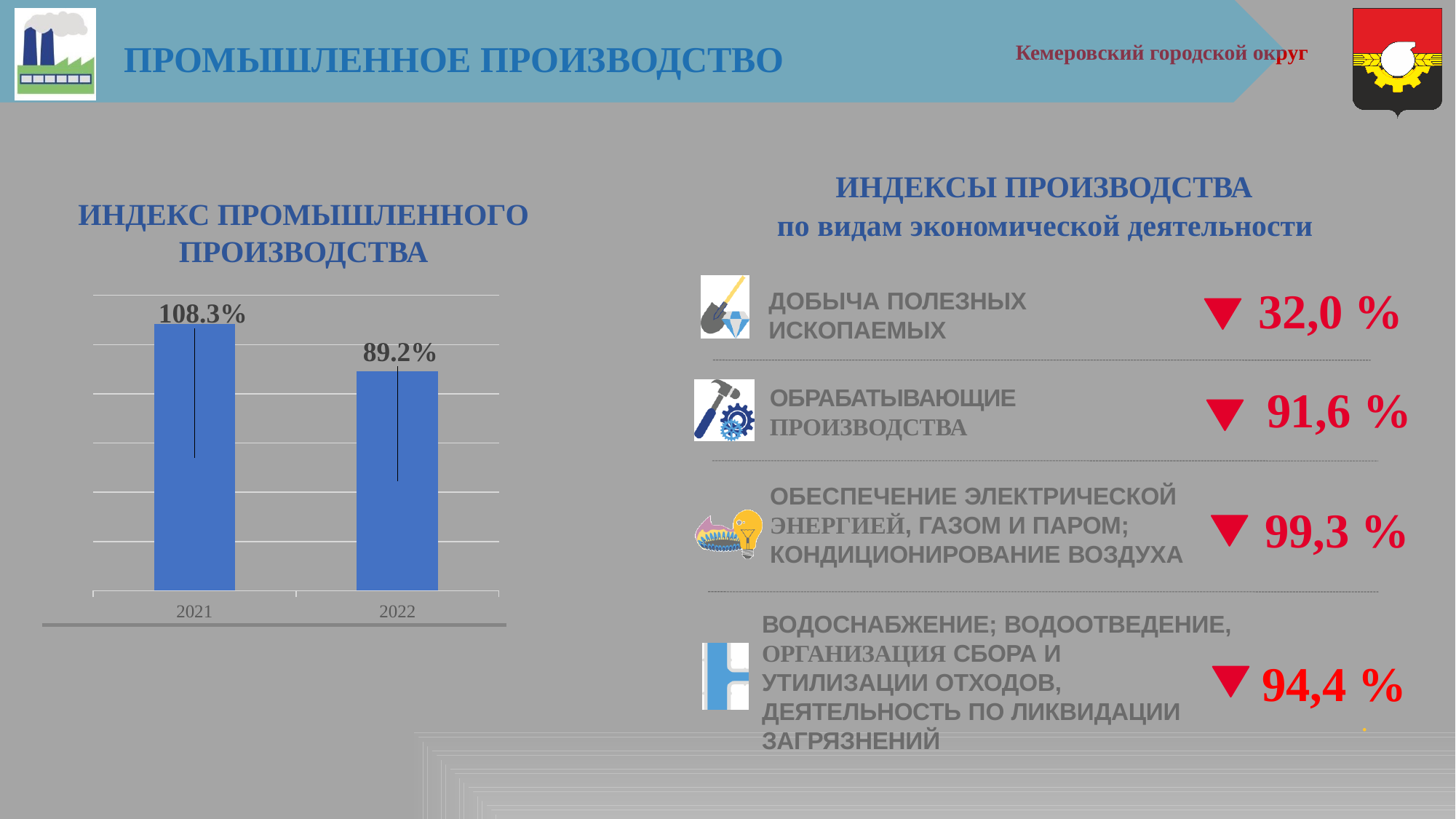
Which year has the lowest value in the bar chart? 2022 How many bars are shown in the bar chart? 2 What colour are the bars in the bar chart? Blue What is the title of the bar chart? ИНДЕКС ПРОМЫШЛЕННОГО ПРОИЗВОДСТВА What is the value for 2022 in the bar chart? 89.2% Which year has the highest value in the bar chart? 2021 What is the difference between the 2021 and 2022 values in the bar chart? 19.1 percentage points Do the values in the bar chart rise or fall from 2021 to 2022? Fall Which is larger in the bar chart, the value for 2021 or for 2022? 2021 What is the value for 2021 in the bar chart? 108.3% What kind of chart is shown on the left of the slide? Bar chart